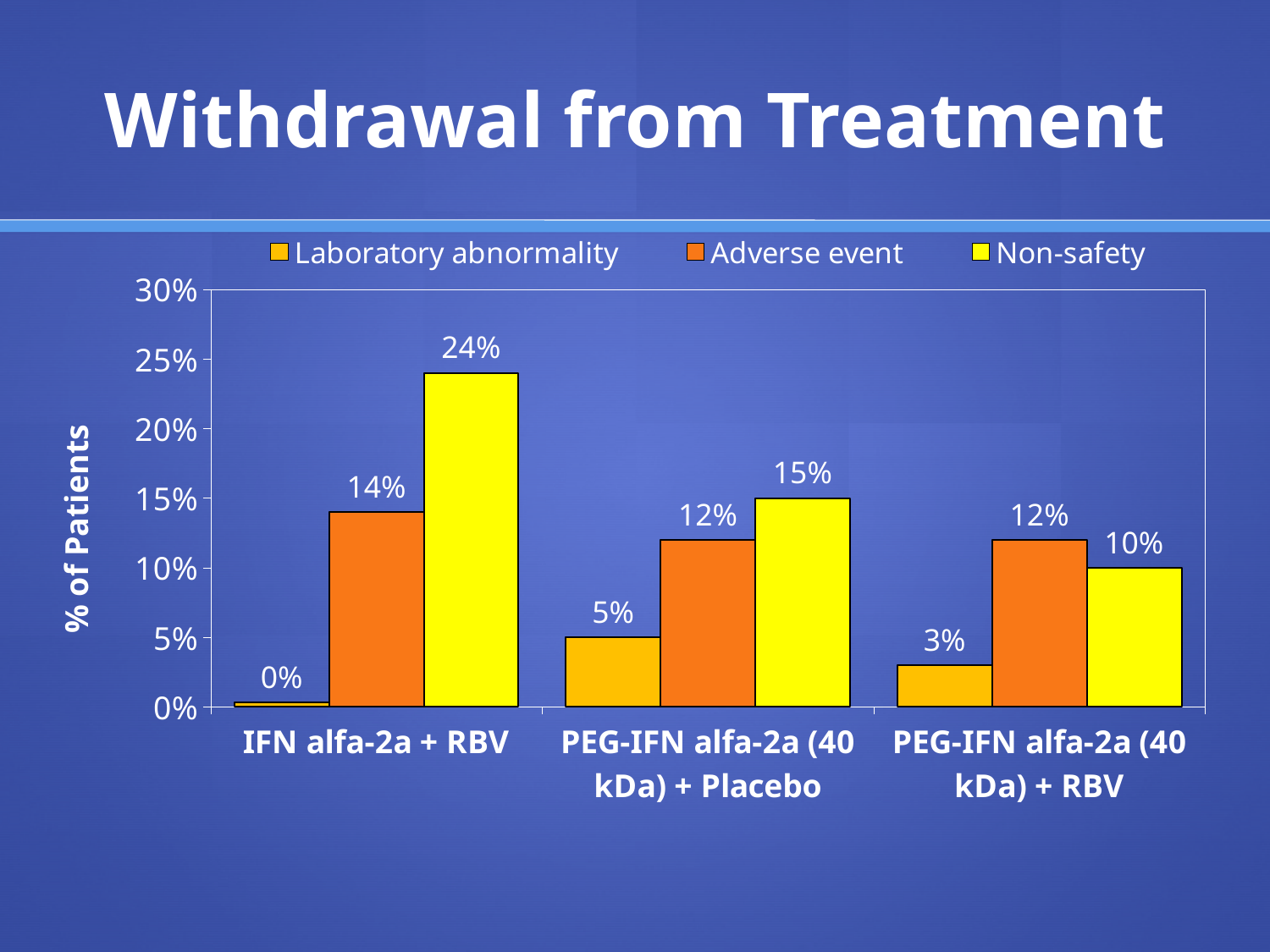
How many treatment groups are shown on the x axis? 3 Which is larger: the Adverse event value for IFN alfa-2a + RBV or for PEG-IFN alfa-2a (40 kDa) + Placebo? IFN alfa-2a + RBV What kind of chart is shown on the slide? Bar chart What is the label of the y axis? % of Patients How many series does the legend list? 3 What is the Non-safety withdrawal value for IFN alfa-2a + RBV? 24% Which treatment group has the highest Non-safety withdrawal value? IFN alfa-2a + RBV What is the Adverse event value for PEG-IFN alfa-2a (40 kDa) + RBV? 12% Which treatment group has the lowest Laboratory abnormality value? IFN alfa-2a + RBV What is the Laboratory abnormality value for IFN alfa-2a + RBV? 0% What is the difference between the Non-safety values for IFN alfa-2a + RBV and PEG-IFN alfa-2a (40 kDa) + RBV? 14% What is the Laboratory abnormality value for PEG-IFN alfa-2a (40 kDa) + Placebo? 5%